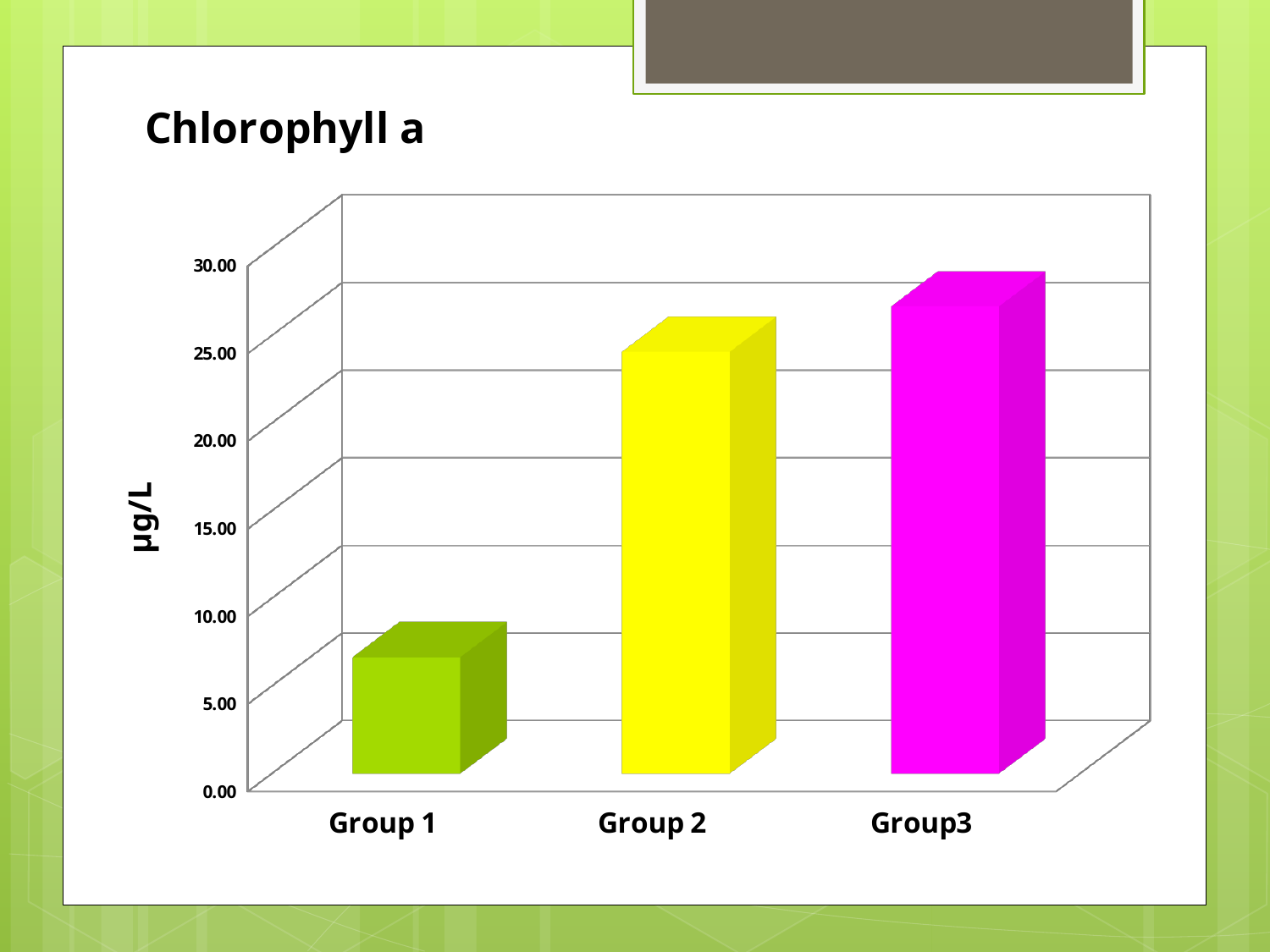
What is the title of the chart? Chlorophyll a How many groups are plotted in the chart? 3 Which has a larger value, Group 1 or Group 2? Group 2 Is the value for Group3 greater or less than 25.00? greater Which group has the highest chlorophyll a value? Group3 What kind of chart is shown on the slide? bar chart Is the value for Group 2 greater or less than 20.00? greater Do the values rise or fall from Group 1 to Group3? rise What is the label on the vertical axis of the chart? µg/L Which has a larger value, Group 2 or Group3? Group3 Is the value for Group 1 greater or less than 10.00? less Which group has the lowest chlorophyll a value? Group 1